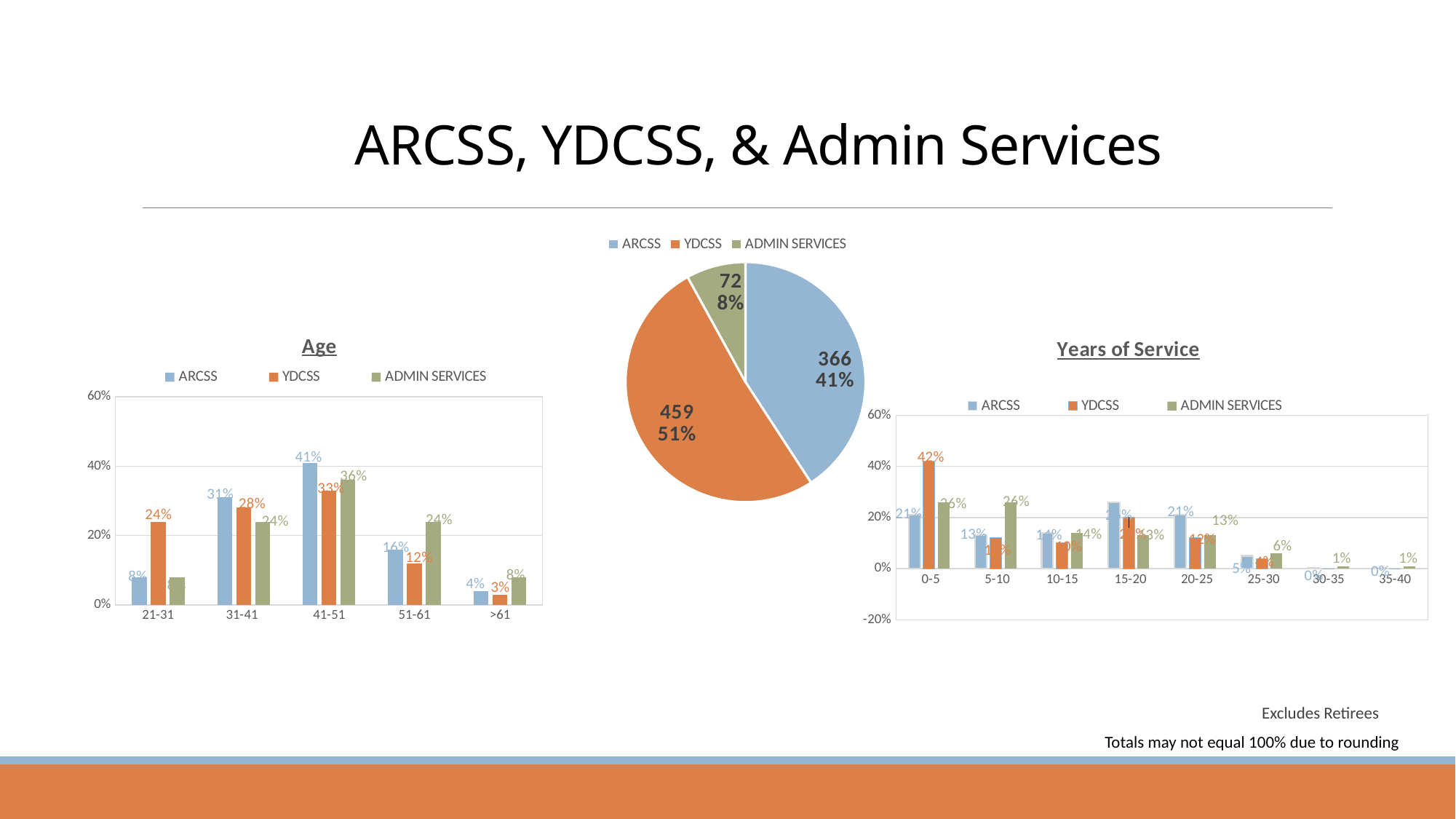
In the Years of Service chart, is the ADMIN SERVICES value for 5-10 larger or smaller than the ARCSS value for 5-10? larger In the pie chart, which group has the largest slice? YDCSS In the pie chart, what share does ADMIN SERVICES have? 8% In the Age chart, which age group has the lowest ARCSS value? >61 In the Age chart, which age group has the highest YDCSS value? 41-51 In the Age chart, what is the value for ARCSS in the 41-51 age group? 41% How many series does the legend of the Years of Service chart list? 3 In the Years of Service chart, what is the value for YDCSS in the 0-5 category? 42% In the Age chart, what is the difference between the YDCSS and ARCSS values for the 21-31 age group? 16% In the Age chart, what is the value for ADMIN SERVICES in the 51-61 age group? 24% In the pie chart, what number is shown for YDCSS? 459 In the Age chart, how many age groups are shown on the x axis? 5